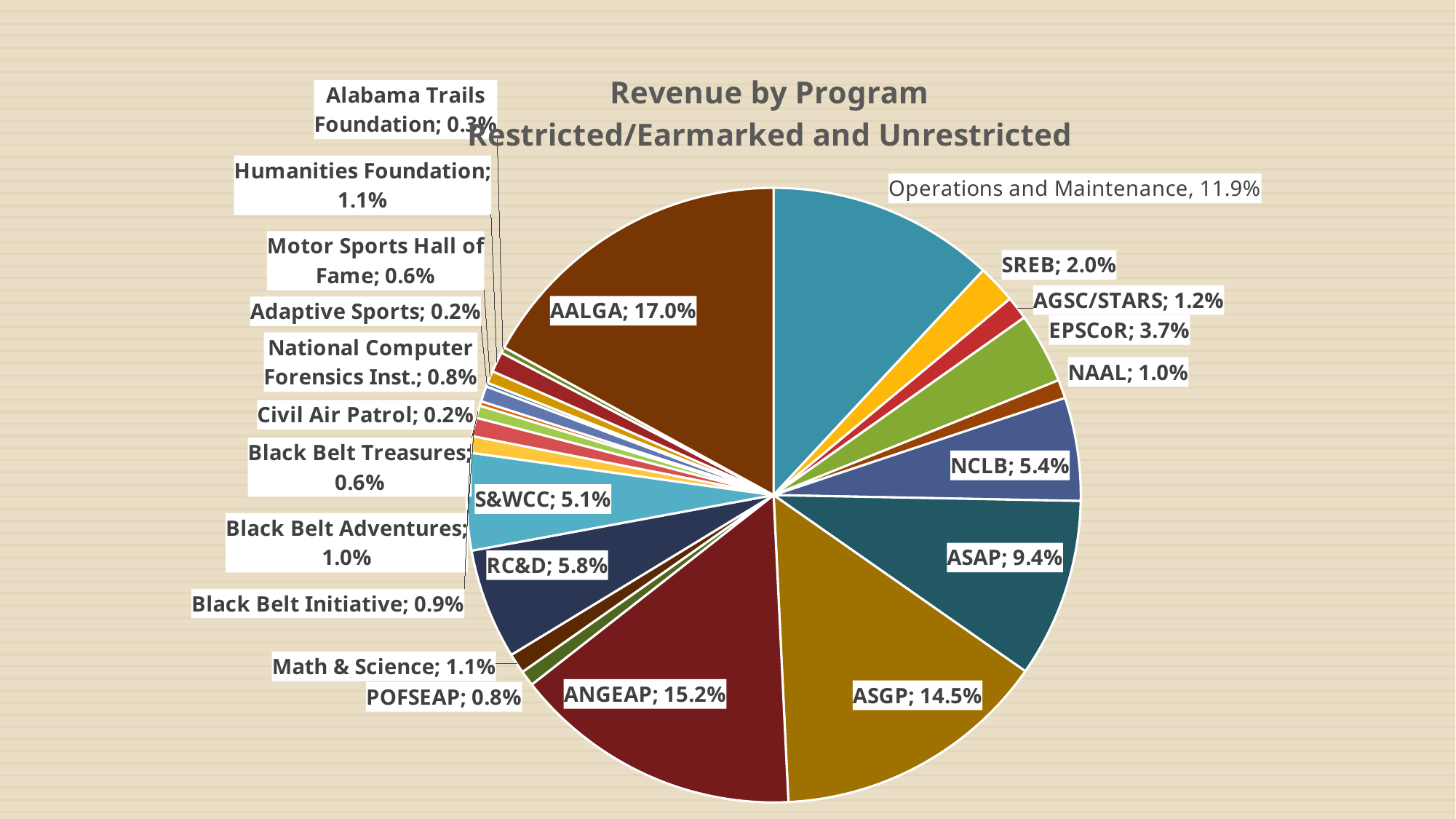
How many program slices are shown in the pie chart? 23 Which program has the largest share of revenue? AALGA What share of revenue does AALGA account for? 17.0% What is the difference between the ASAP share and the NCLB share? 4.0% What is the difference between the ANGEAP and ASGP shares? 0.7% Which is larger, the share for RC&D or the share for NCLB? RC&D What percentage is shown for Operations and Maintenance? 11.9% What is the title of the chart? Revenue by Program Restricted/Earmarked and Unrestricted What is the value for Black Belt Initiative? 0.9% What is the value for ASGP? 14.5% What percentage is labelled for EPSCoR? 3.7% What type of chart is shown on the slide? pie chart